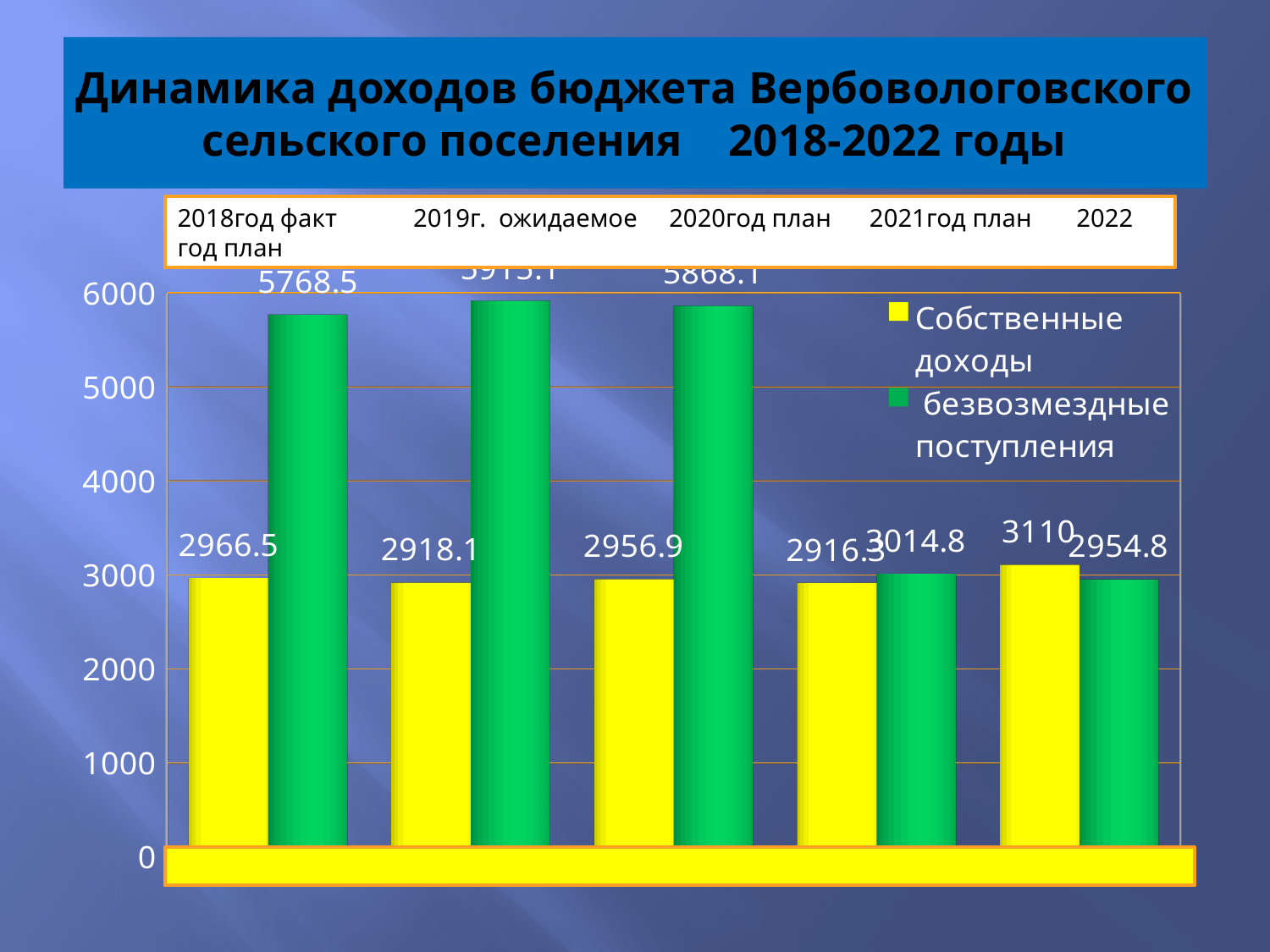
In 2022 год план, which is larger: Собственные доходы or безвозмездные поступления? Собственные доходы Is the value of безвозмездные поступления for 2019 г. ожидаемое greater or less than 5000? greater What is the value of Собственные доходы for 2018 год факт? 2966.5 What kind of chart is shown on the slide? bar chart What is the value of Собственные доходы for 2022 год план? 3110 How many series does the legend list? 2 What is the difference between безвозмездные поступления and Собственные доходы in 2018 год факт? 2802 How many year categories are shown on the chart? 5 Which year has the lowest value of безвозмездные поступления? 2022 год план Which year has the highest value of Собственные доходы? 2022 год план What is the value of безвозмездные поступления for 2021 год план? 3014.8 What is the value of безвозмездные поступления for 2018 год факт? 5768.5